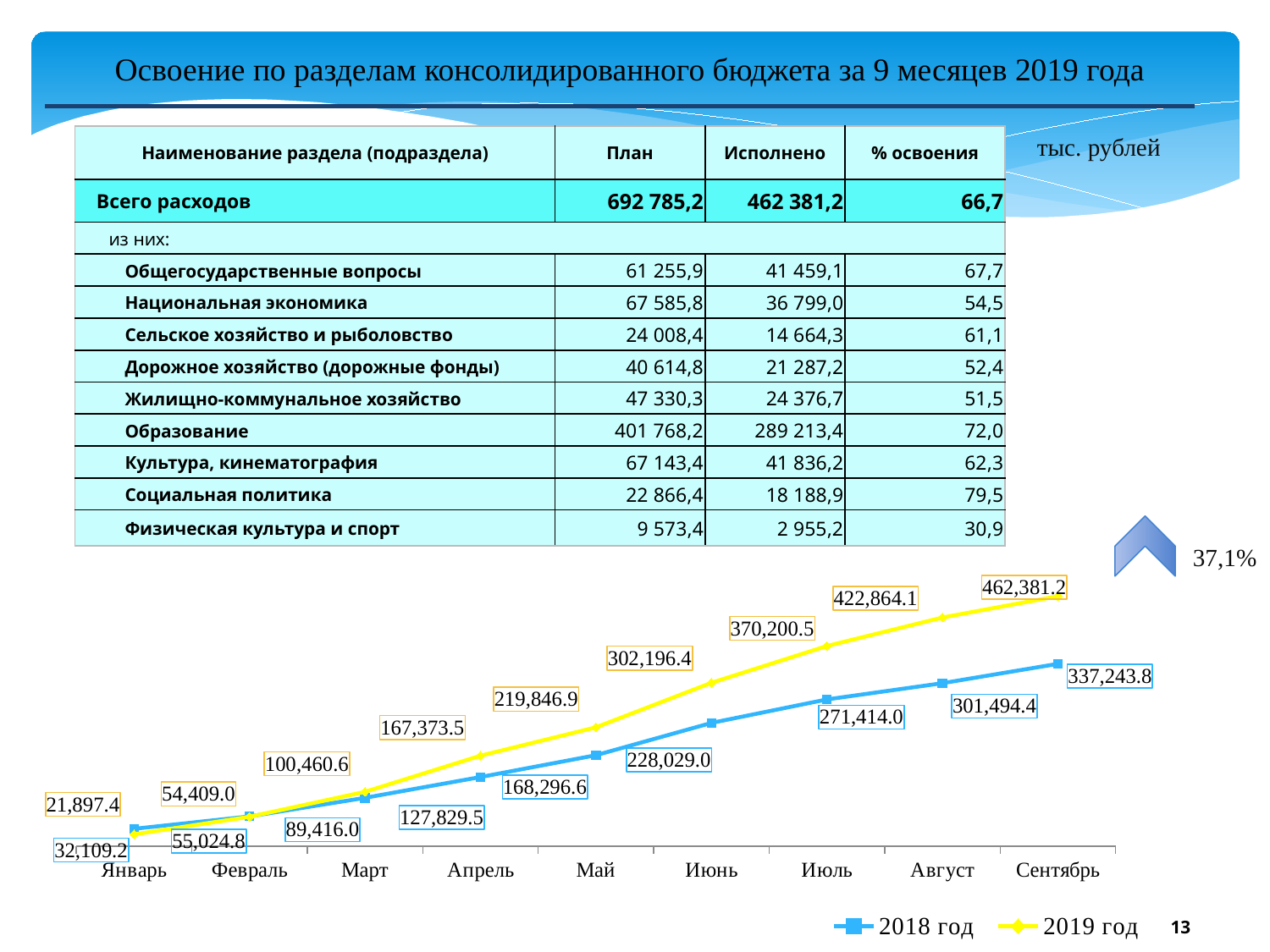
In the line chart, what is the value for 2019 год in Сентябрь? 462,381.2 In the line chart, what is the value for 2018 год in Июнь? 228,029.0 How many months are plotted along the x axis of the line chart? 9 In the line chart, do the values for 2019 год rise or fall from Январь to Сентябрь? rise In the line chart, which series has the larger value in Июль, 2018 год or 2019 год? 2019 год In the line chart, what is the value for 2018 год in Сентябрь? 337,243.8 In the line chart, which month has the lowest value for 2018 год? Январь In the line chart, what is the difference between the 2019 год and 2018 год values in Сентябрь? 125,137.4 In the line chart, which month has the highest value for 2019 год? Сентябрь How many series does the legend of the line chart list? 2 What kind of chart is shown at the bottom of the slide? line chart In the line chart, what is the value for 2019 год in Март? 100,460.6